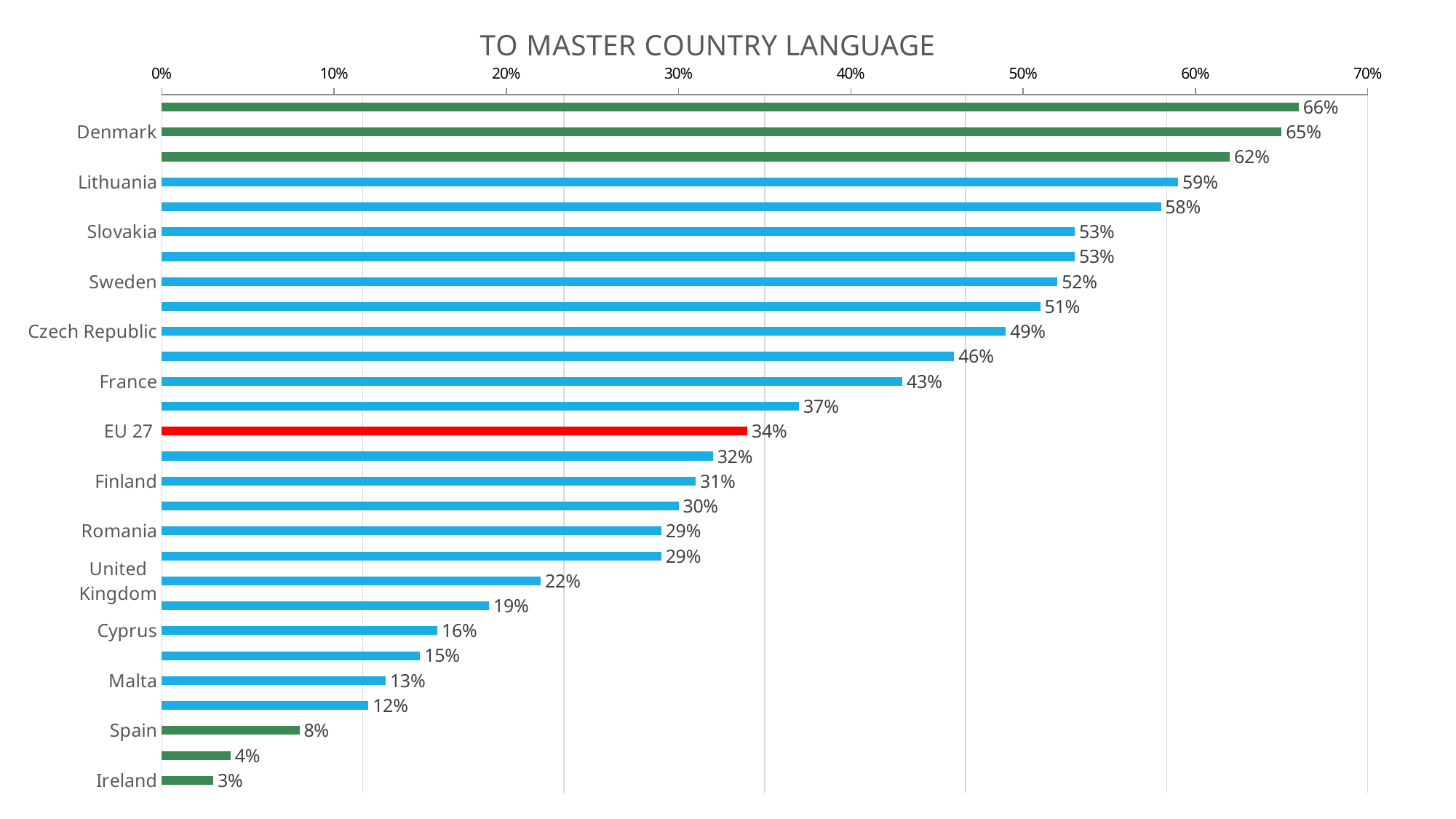
Which is larger, the value for Lithuania or the value for Sweden? Lithuania What is the title of the chart? TO MASTER COUNTRY LANGUAGE Is the value for Finland greater or less than 40%? less What is the value for Czech Republic? 49% Which category has the lowest value? Ireland What is the value for United Kingdom? 22% What kind of chart is shown on the slide? bar chart What is the difference between the values for Denmark and Spain? 57% What is the value for Denmark? 65% What is the difference between the values for France and EU 27? 9% What is the value for Ireland? 3% What is the value for EU 27? 34%